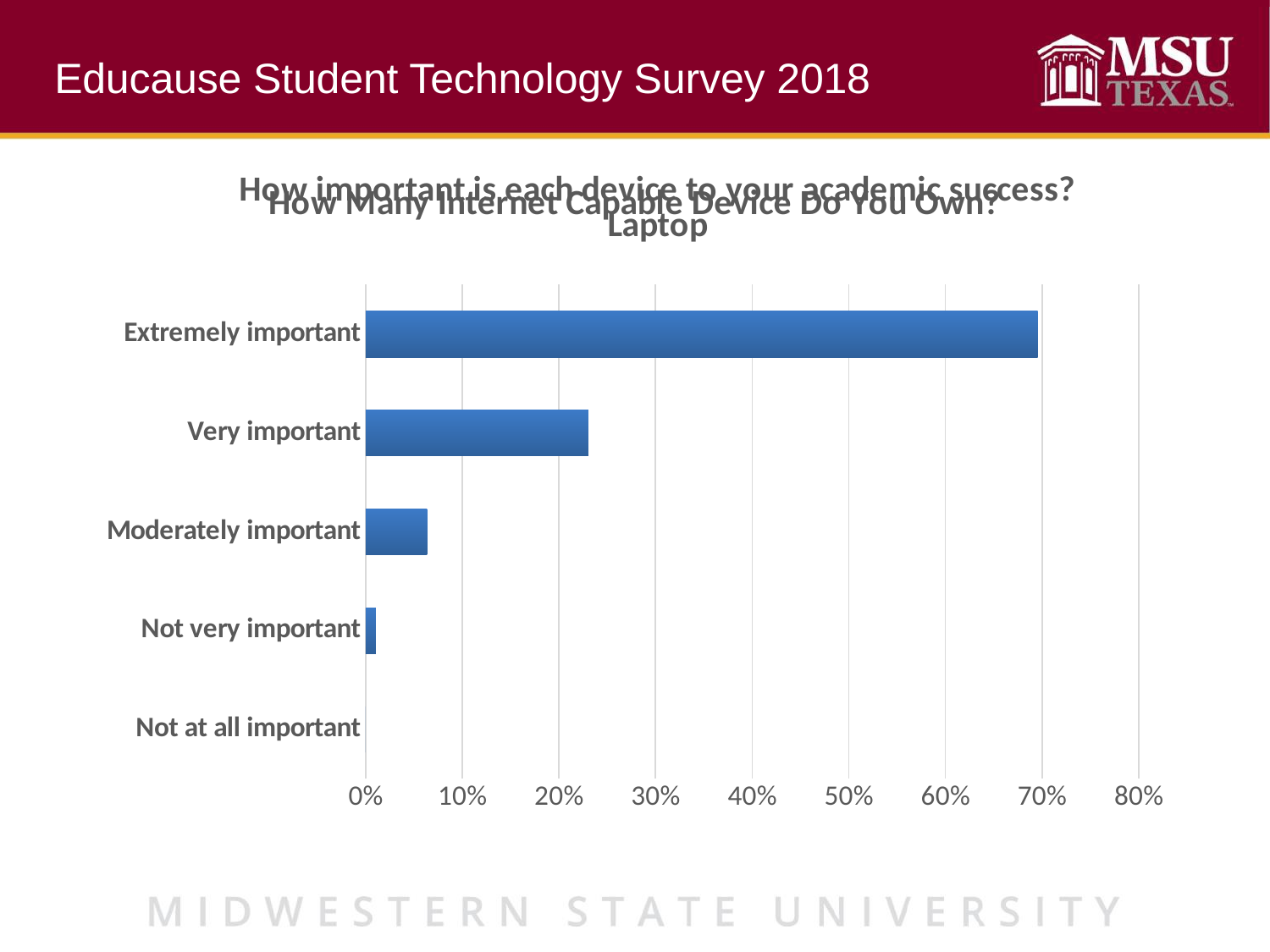
Is the value for Very important greater or less than 30%? less Which is larger, the value for Very important or the value for Moderately important? Very important Is the value for Very important greater or less than 20%? greater Is the value for Moderately important greater or less than 10%? less What kind of chart is shown on the slide? bar chart What is the highest tick label shown on the horizontal axis? 80% Which is larger, the value for Extremely important or the value for Very important? Extremely important How many categories are shown on the chart's vertical axis? 5 Which device is named in the chart's subtitle? Laptop Which category has the highest value? Extremely important Which category has the lowest value? Not at all important